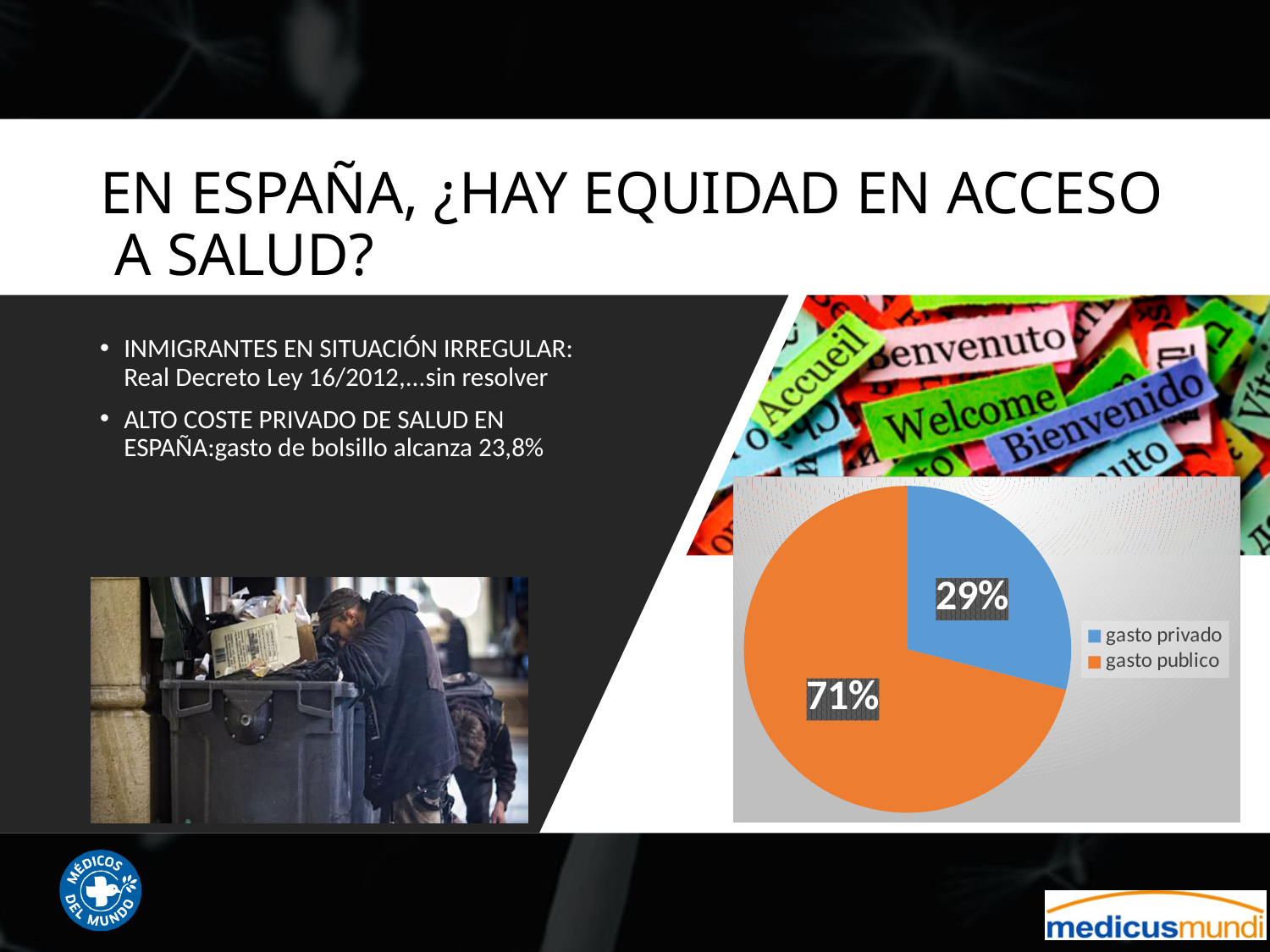
Which slice of the pie is the largest? gasto publico What share of the pie does gasto privado represent? 29% What colour is the gasto privado slice? blue How many slices does the pie chart have? 2 What share of the pie does gasto publico represent? 71% Which slice of the pie is the smallest? gasto privado Which is larger, gasto privado or gasto publico? gasto publico How many entries does the legend list? 2 What is the difference in percentage points between gasto publico and gasto privado? 42 What kind of chart is shown on the slide? pie chart What colour is the gasto publico slice? orange